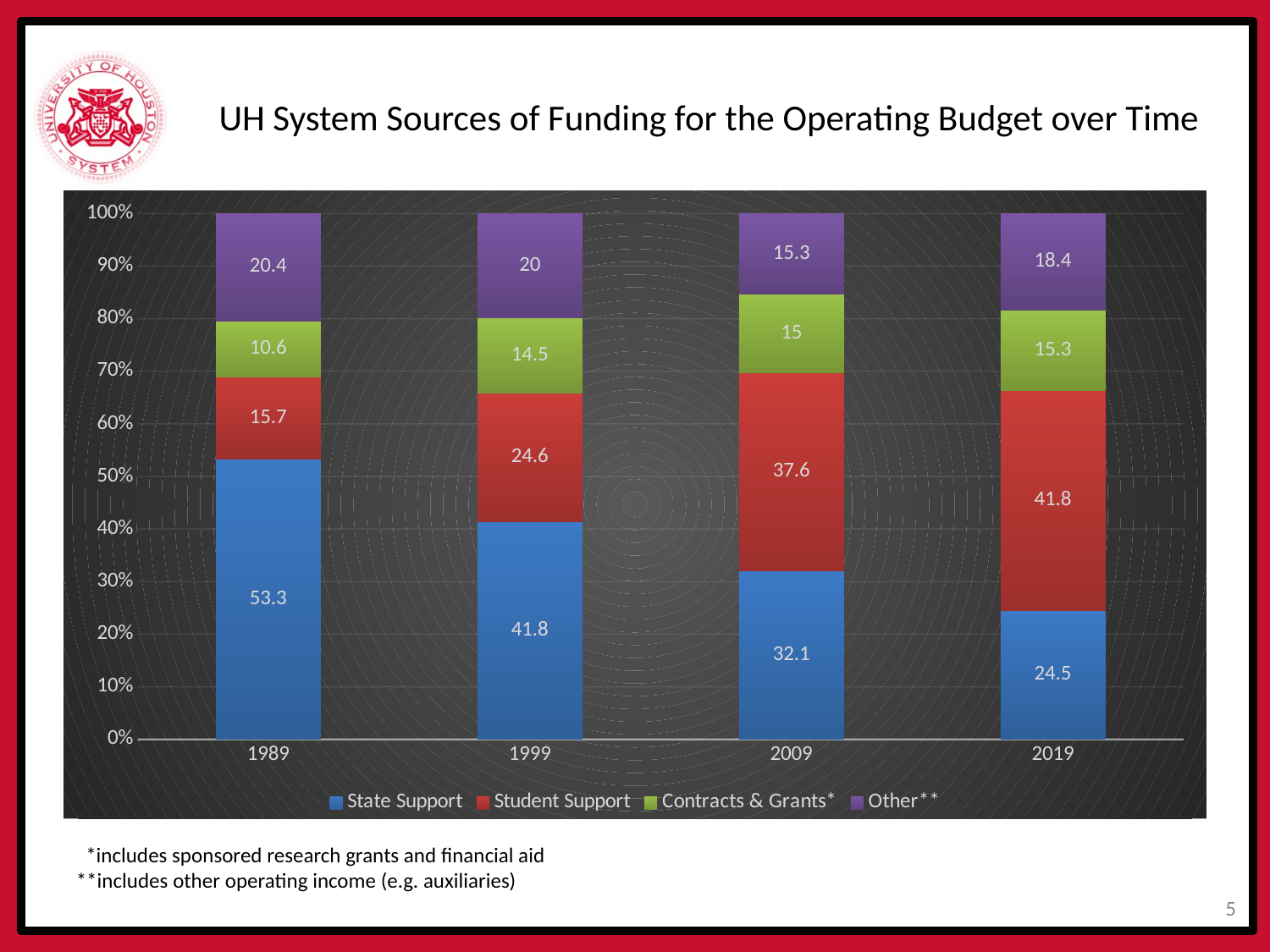
What is the Student Support value for 2019? 41.8 Which is larger in 2009, State Support or Student Support? Student Support What is the State Support value for 1989? 53.3 How many years are shown on the x axis? 4 How many series does the legend list? 4 In which year is Student Support lowest? 1989 In which year is State Support highest? 1989 What is the Other** value for 2009? 15.3 What is the Contracts & Grants* value for 1999? 14.5 Does State Support rise or fall from 1989 to 2019? Fall What kind of chart is shown? Stacked bar chart What is the difference between the State Support values for 1989 and 2019? 28.8